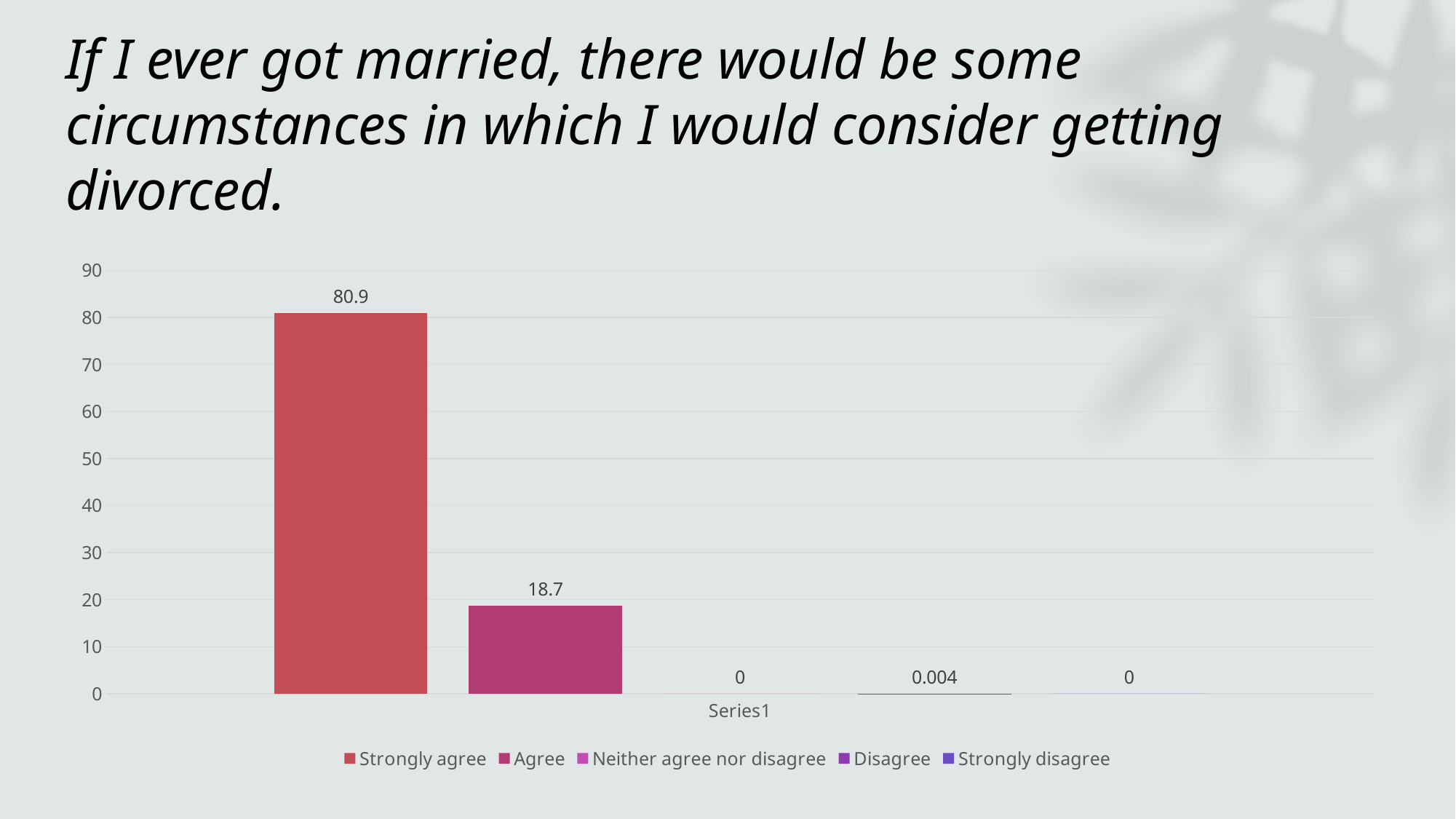
Which is larger, the value for Agree or the value for Disagree? Agree What is the label shown on the x axis beneath the bars? Series1 What is the value for Agree? 18.7 What is the value for Neither agree nor disagree? 0 What is the value for Disagree? 0.004 Which response has the highest value? Strongly agree What is the difference between the values for Strongly agree and Agree? 62.2 What is the value for Strongly agree? 80.9 Is the value for Agree greater or less than 20? less How many series does the legend list? 5 Is the value for Strongly agree greater or less than 80? greater What kind of chart is shown on the slide? bar chart